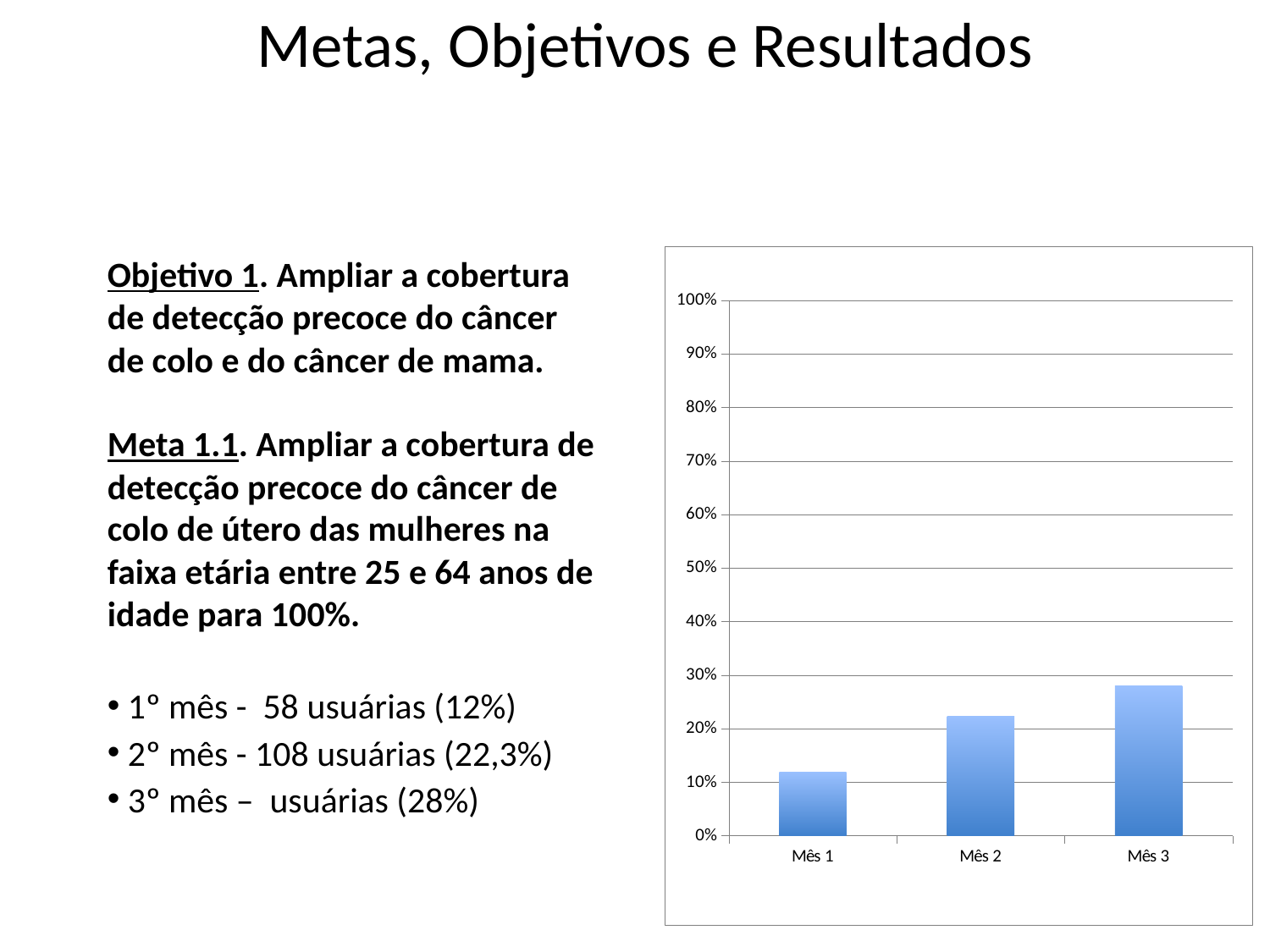
How many categories are plotted on the x axis of the chart? 3 What is the maximum value shown on the chart's y axis? 100% What kind of chart is shown on the slide? bar chart Is the value for Mês 3 greater or less than 30%? less Do the values rise or fall from Mês 1 to Mês 3? rise Is the value for Mês 2 greater or less than 20%? greater Is the value for Mês 3 greater or less than 20%? greater Which is larger, the value for Mês 1 or the value for Mês 2? Mês 2 Which month has the lowest bar in the chart? Mês 1 What colour are the bars in the chart? blue Which month has the highest bar in the chart? Mês 3